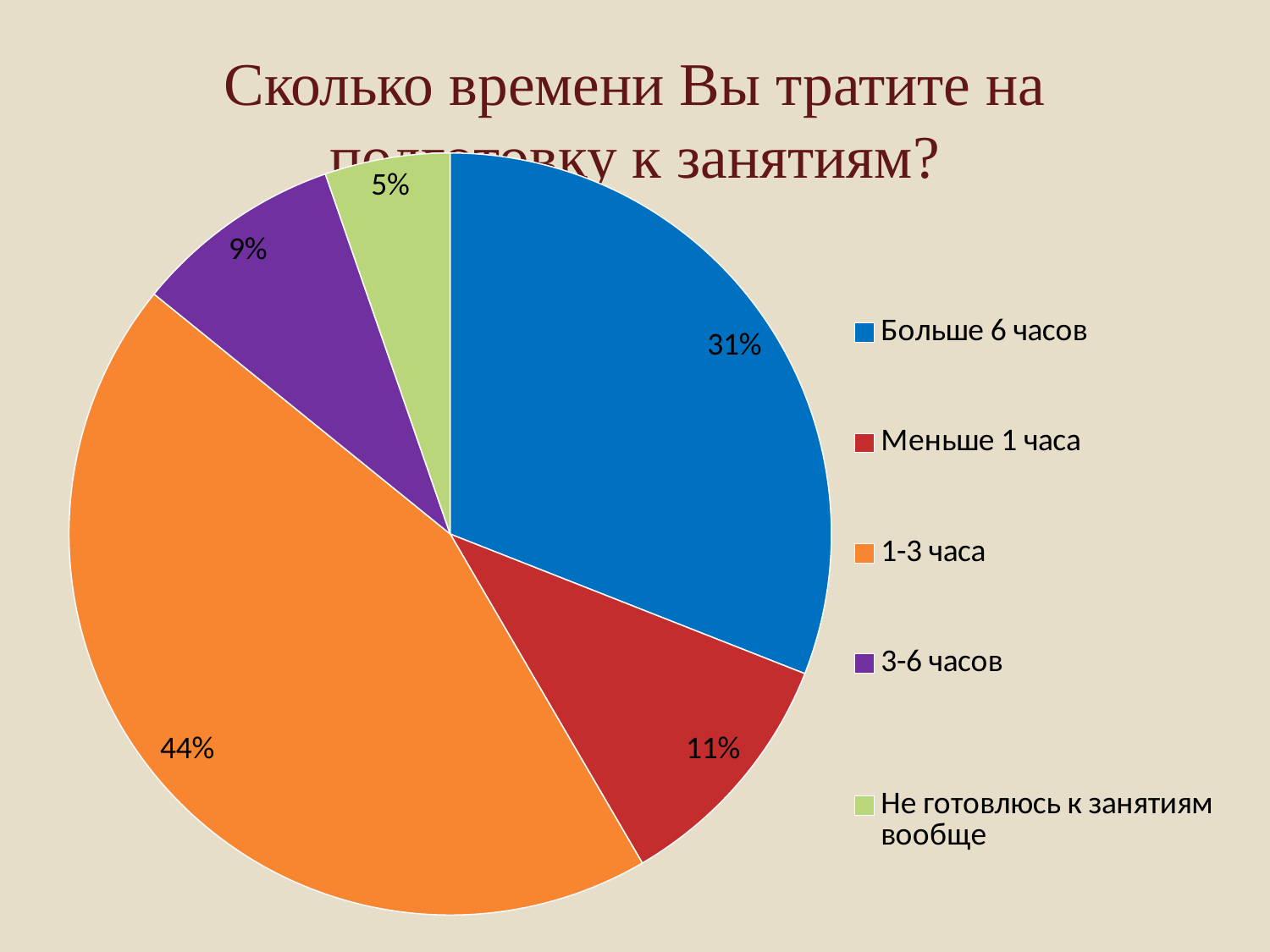
Which category has the largest slice of the pie? 1-3 часа What is the difference in percentage points between the "1-3 часа" slice and the "Больше 6 часов" slice? 13% Which colour represents "3-6 часов" in the legend? Purple What kind of chart is shown on the slide? Pie chart What share of the pie is labelled for "Больше 6 часов"? 31% Which category has the smallest slice of the pie? Не готовлюсь к занятиям вообще What share of the pie is labelled for "Не готовлюсь к занятиям вообще"? 5% What share of the pie is labelled for "Меньше 1 часа"? 11% How many categories does the pie chart have? 5 Which slice is larger, "Меньше 1 часа" or "3-6 часов"? Меньше 1 часа